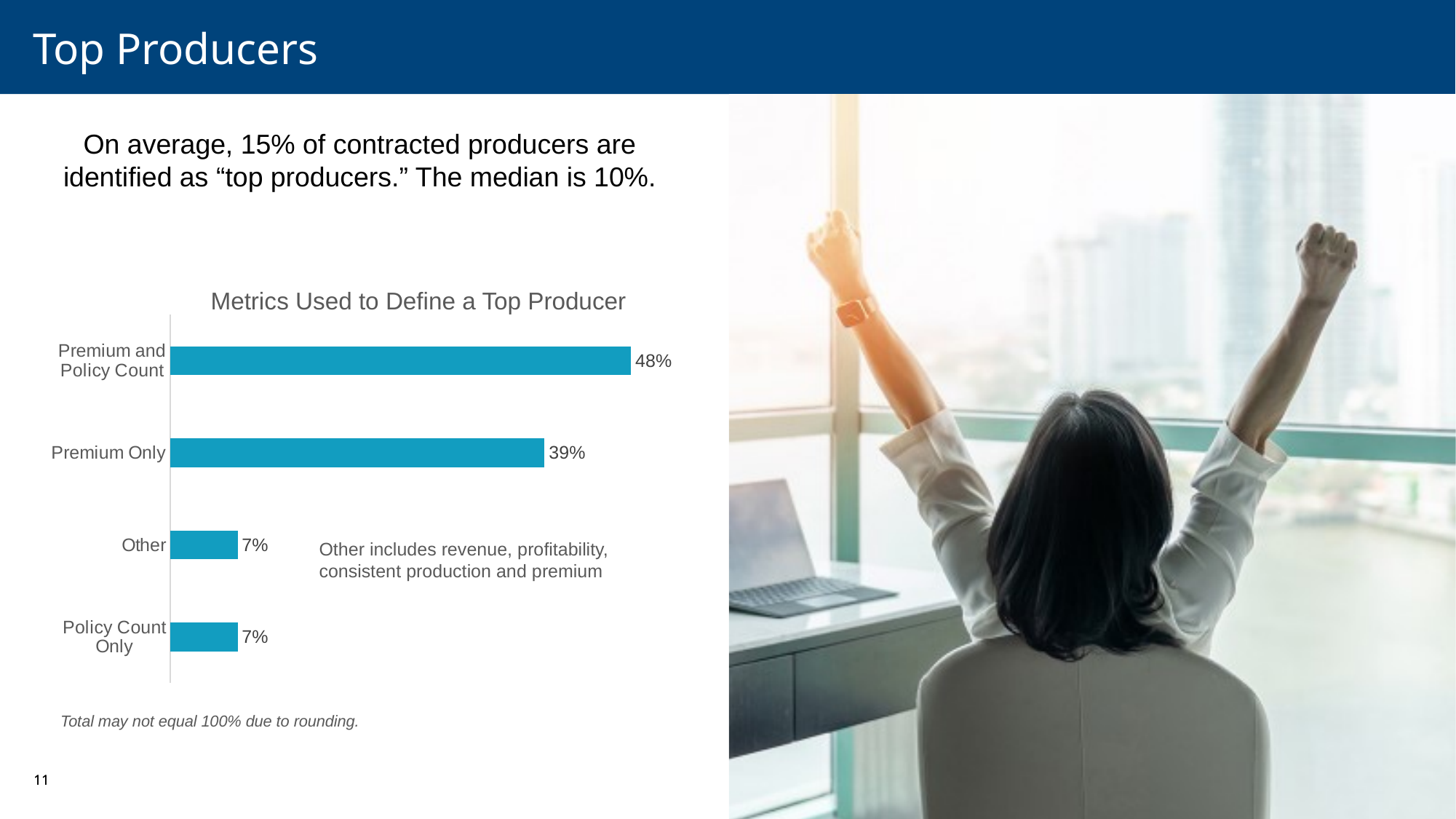
Which is larger, the value for Premium Only or the value for Policy Count Only? Premium Only What is the value for Premium and Policy Count? 48% Which category has the highest value? Premium and Policy Count What is the difference between the values for Premium and Policy Count and Premium Only? 9% How many categories are shown in the chart? 4 According to the note on the chart, what does the Other category include? Revenue, profitability, consistent production and premium What is the difference between the values for Premium Only and Other? 32% What is the value for Policy Count Only? 7% What is the title of the chart? Metrics Used to Define a Top Producer What is the value for Premium Only? 39% What is the value for Other? 7% What kind of chart is shown on the slide? Bar chart